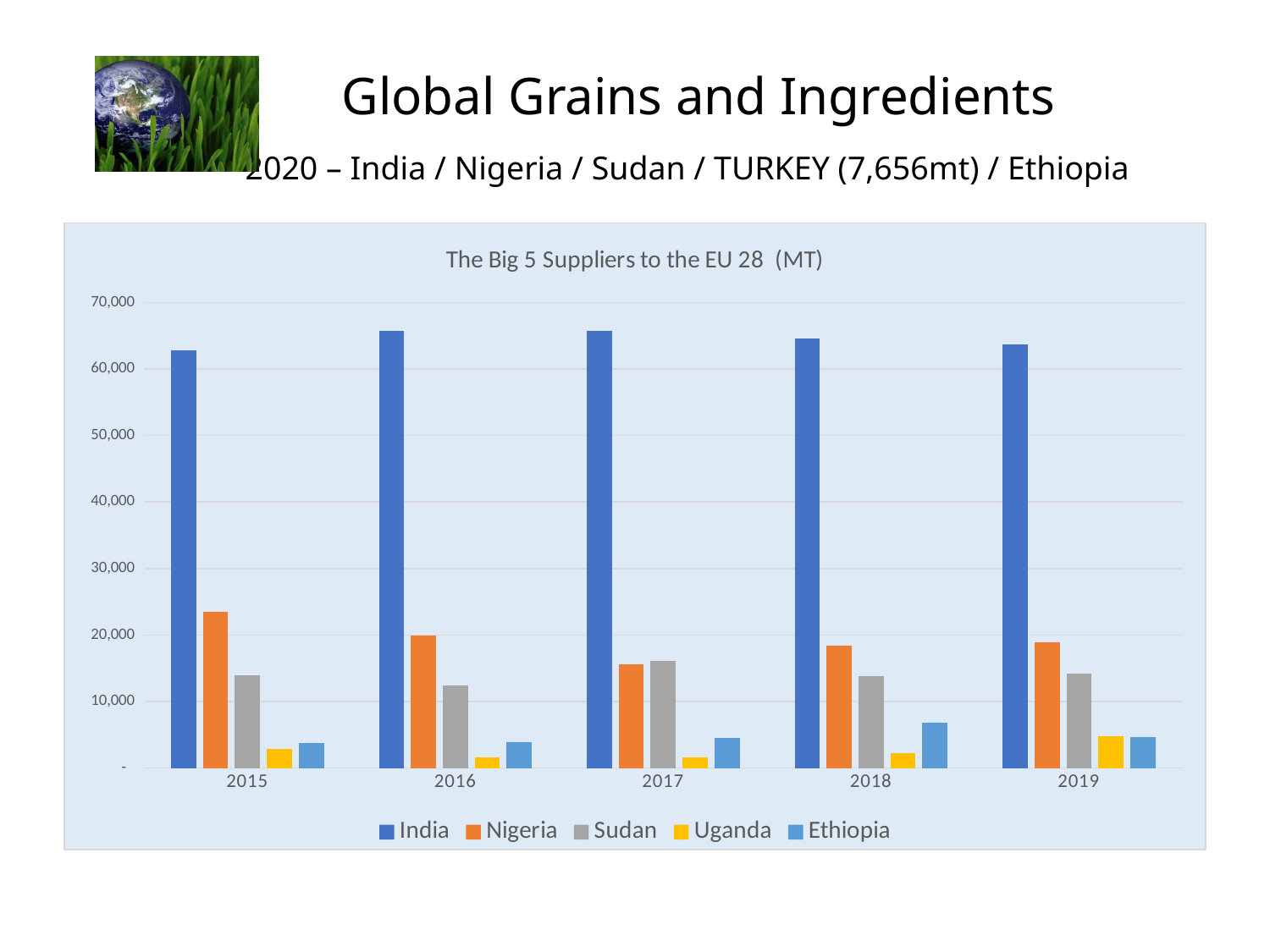
In 2018, which is larger: the value for Ethiopia or the value for Uganda? Ethiopia How many years are shown on the x axis? 5 In 2015, which is larger: the value for Nigeria or the value for Sudan? Nigeria Is the value for India in 2015 greater or less than 60,000? greater Which supplier has the lowest value in 2016? Uganda Which supplier has the highest value in 2015? India What kind of chart is shown on the slide? bar chart Does the value for Nigeria rise or fall from 2015 to 2017? fall What is the title of the chart? The Big 5 Suppliers to the EU 28 (MT) Is the value for Nigeria in 2015 greater or less than 20,000? greater How many series does the legend list? 5 Is the value for Nigeria in 2017 greater or less than 20,000? less